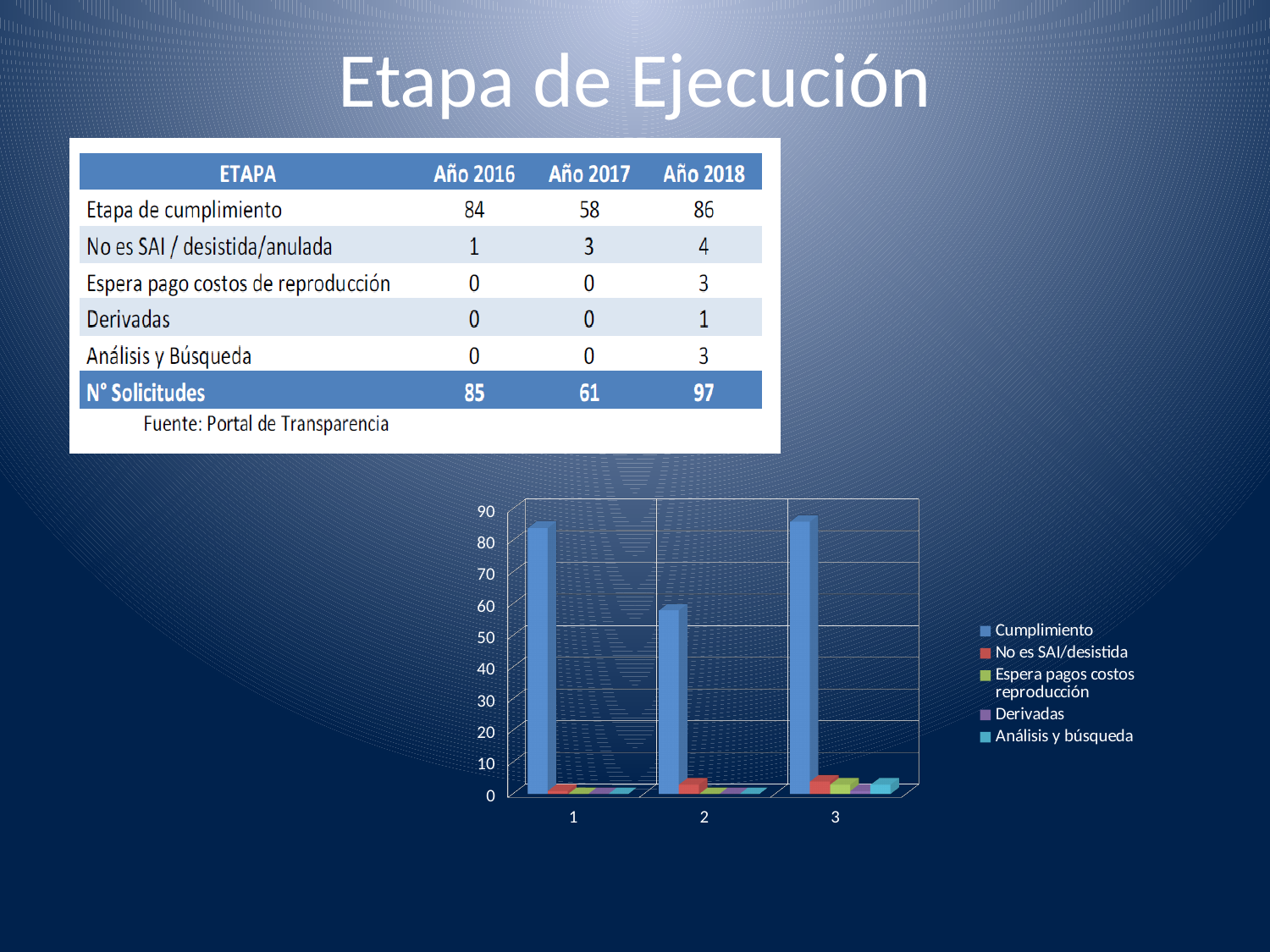
How many categories are shown on the x axis of the chart? 3 Is the Cumplimiento value for category 2 greater or less than 50? greater Does the Cumplimiento value rise or fall from category 1 to category 2? fall Which category has the lowest Cumplimiento bar in the chart? 2 Is the Cumplimiento value for category 1 greater or less than 80? greater Is the Cumplimiento value for category 3 greater or less than 70? greater Which is larger in the chart, the Cumplimiento value for category 1 or for category 2? category 1 What is the first entry listed in the chart legend? Cumplimiento What colour are the Cumplimiento bars in the chart? blue How many series does the chart legend list? 5 What kind of chart is shown on the slide? bar chart